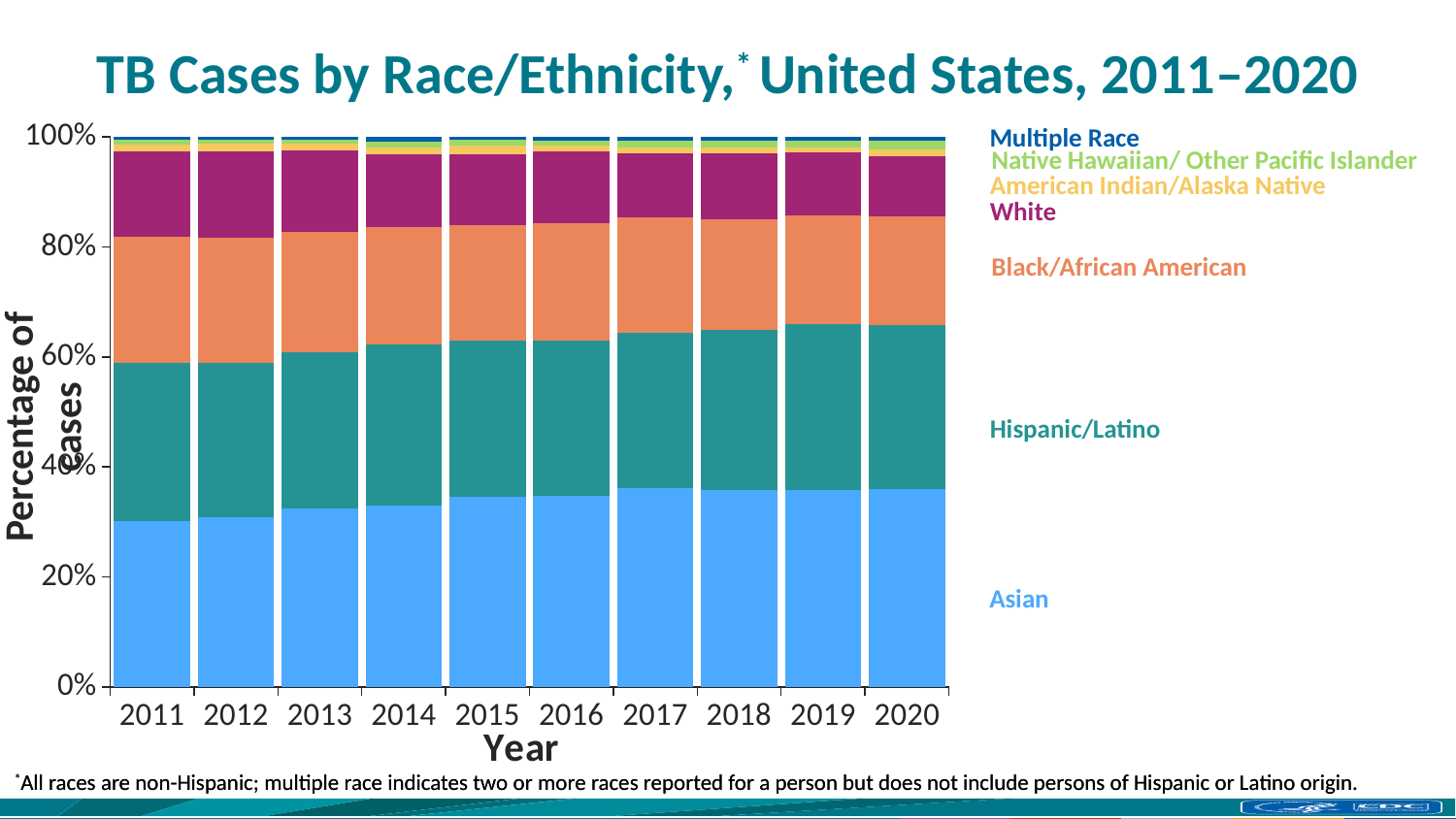
Which group is plotted at the bottom of each stacked bar? Asian How many years are shown along the x axis? 10 Is the Asian share of TB cases larger in 2011 or in 2020? 2020 What is the label on the x axis? Year Is the Asian share of TB cases in 2011 greater or less than 40%? less Is the Asian share of TB cases in 2020 greater or less than 20%? greater Which race/ethnicity group has the largest share of TB cases in 2020? Asian Is the combined share of Asian and Hispanic/Latino cases in 2020 greater or less than 60%? greater What is the title of the chart? TB Cases by Race/Ethnicity, United States, 2011–2020 Does the Asian share of TB cases rise or fall from 2011 to 2020? rise What kind of chart is shown on the slide? Stacked bar chart How many race/ethnicity groups does the legend list? 7